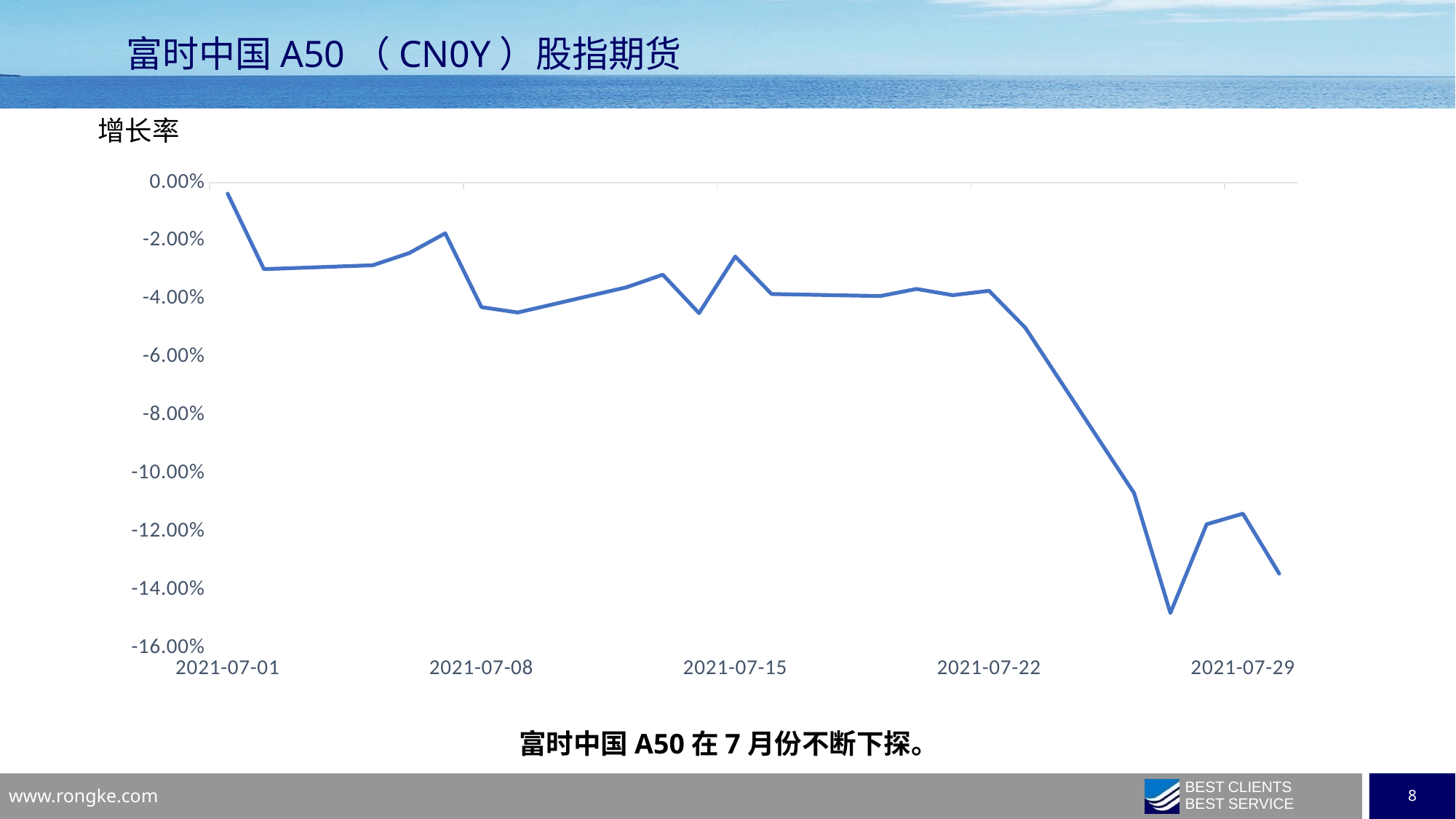
Is the value at 2021-07-29 greater or less than -10.00%? less Which is larger, the value at 2021-07-08 or the value at 2021-07-29? 2021-07-08 What is the label shown above the y axis of the chart? 增长率 Is the value at 2021-07-15 greater or less than -2.00%? less Is the lowest point on the line greater or less than -14.00%? less What is the title of the slide containing the chart? 富时中国 A50 （CN0Y） 股指期货 What kind of chart is shown on the slide? line chart How many date labels are shown on the x axis? 5 Overall, do the values rise or fall from 2021-07-01 to 2021-07-29? fall